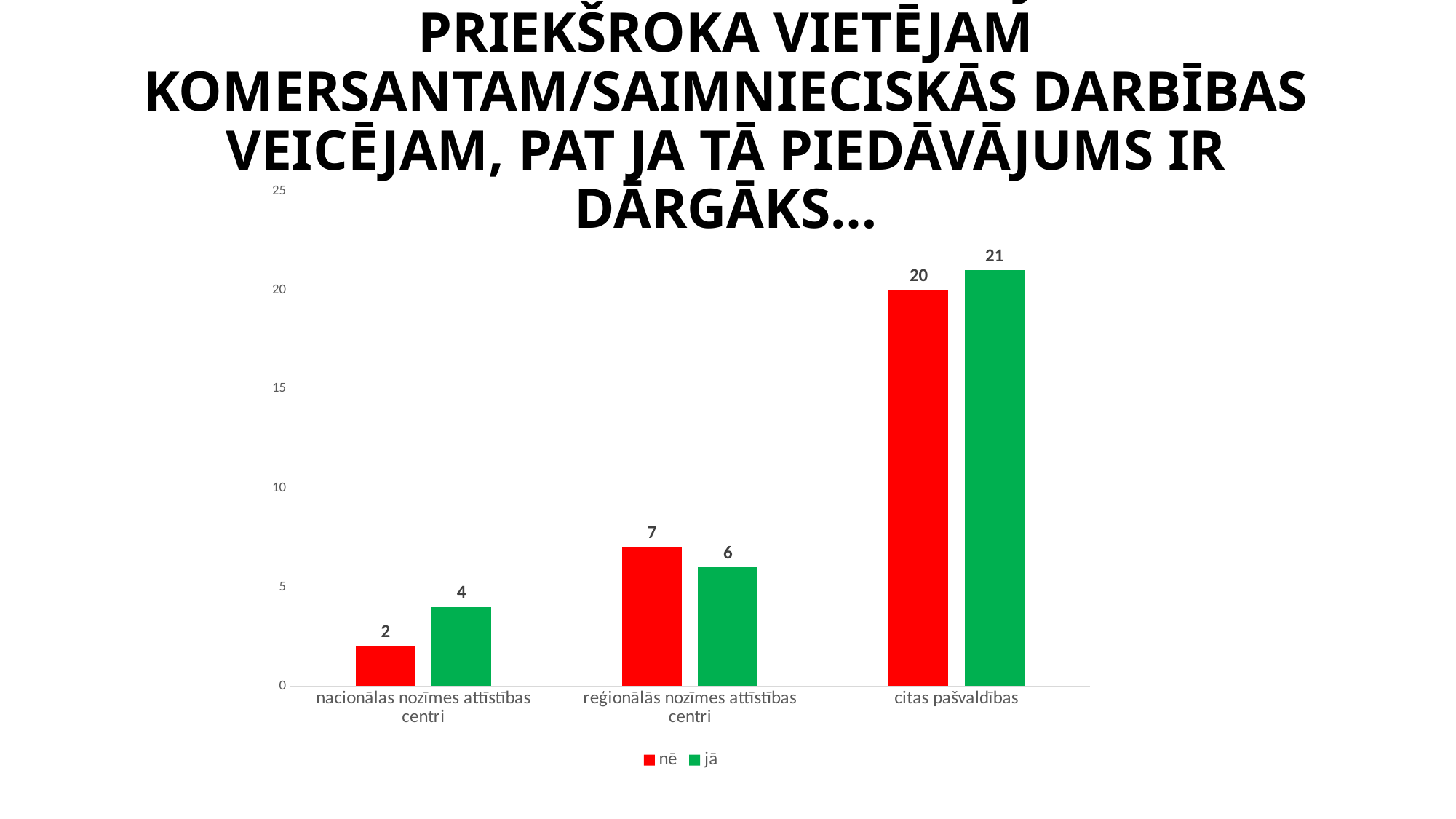
What colour represents the "jā" series? green What kind of chart is shown on the slide? bar chart For "reģionālās nozīmes attīstības centri", which is larger: "nē" or "jā"? nē What is the value of "jā" for "nacionālas nozīmes attīstības centri"? 4 Which category has the lowest "nē" value? nacionālas nozīmes attīstības centri Is the "jā" value for "citas pašvaldības" greater or less than 20? greater How many categories are shown on the x axis? 3 Which category has the highest "jā" value? citas pašvaldības What is the value of "nē" for "citas pašvaldības"? 20 How many series does the legend list? 2 What is the value of "nē" for "reģionālās nozīmes attīstības centri"? 7 What is the difference between the "jā" and "nē" values for "nacionālas nozīmes attīstības centri"? 2